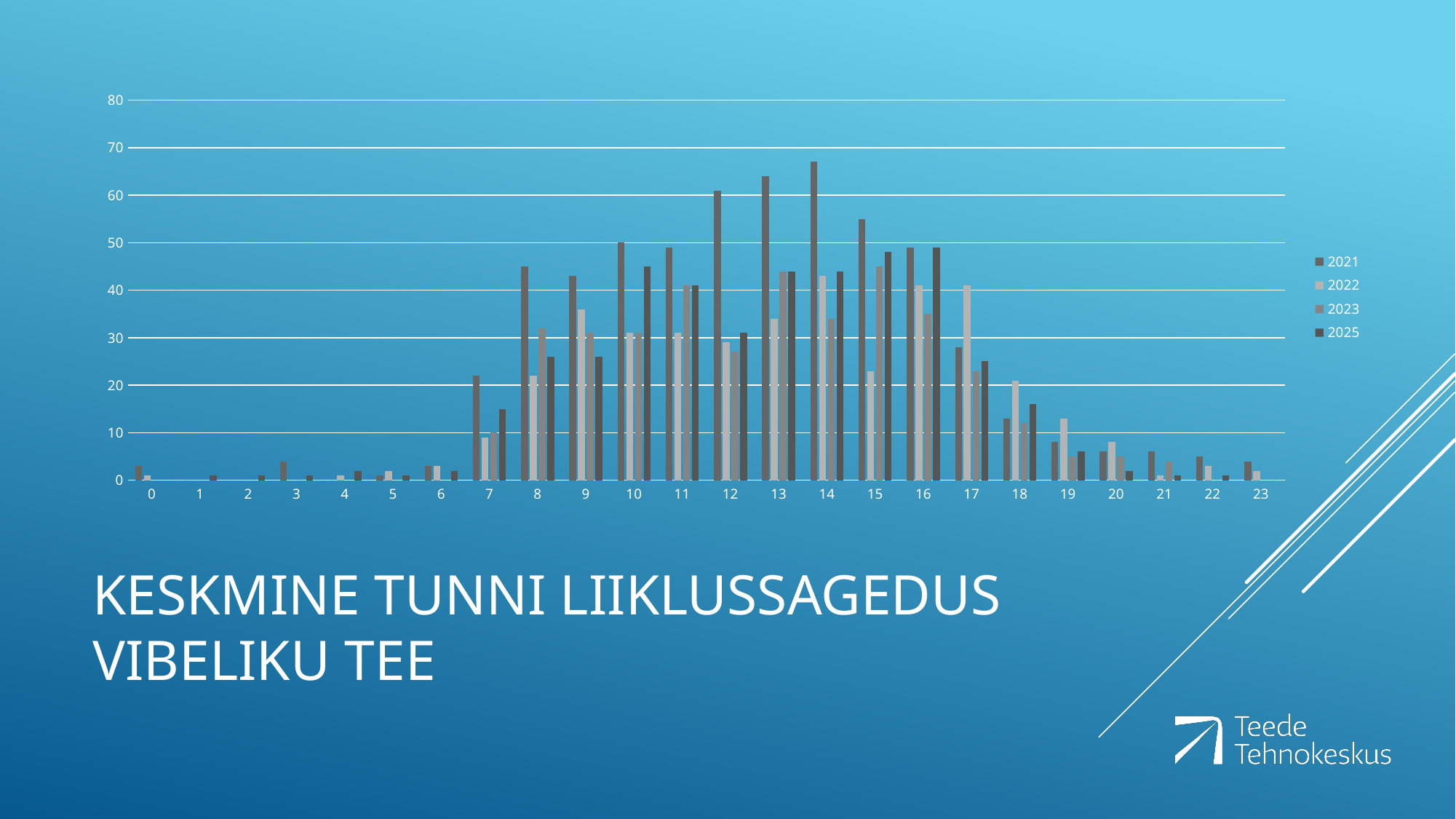
Which years are listed in the chart legend? 2021, 2022, 2023, 2025 For the 2021 series, do the values rise or fall from hour 17 to hour 23? fall Is the 2025 value at hour 9 greater or less than 30? less What is the title of the slide containing the chart? KESKMINE TUNNI LIIKLUSSAGEDUS VIBELIKU TEE Is the 2022 value at hour 19 greater or less than 10? greater Is the 2021 value at hour 15 greater or less than 50? greater How many series does the legend list? 4 How many hour categories are shown on the x axis? 24 What kind of chart is shown on the slide? bar chart At hour 17, which series has the larger value, 2022 or 2025? 2022